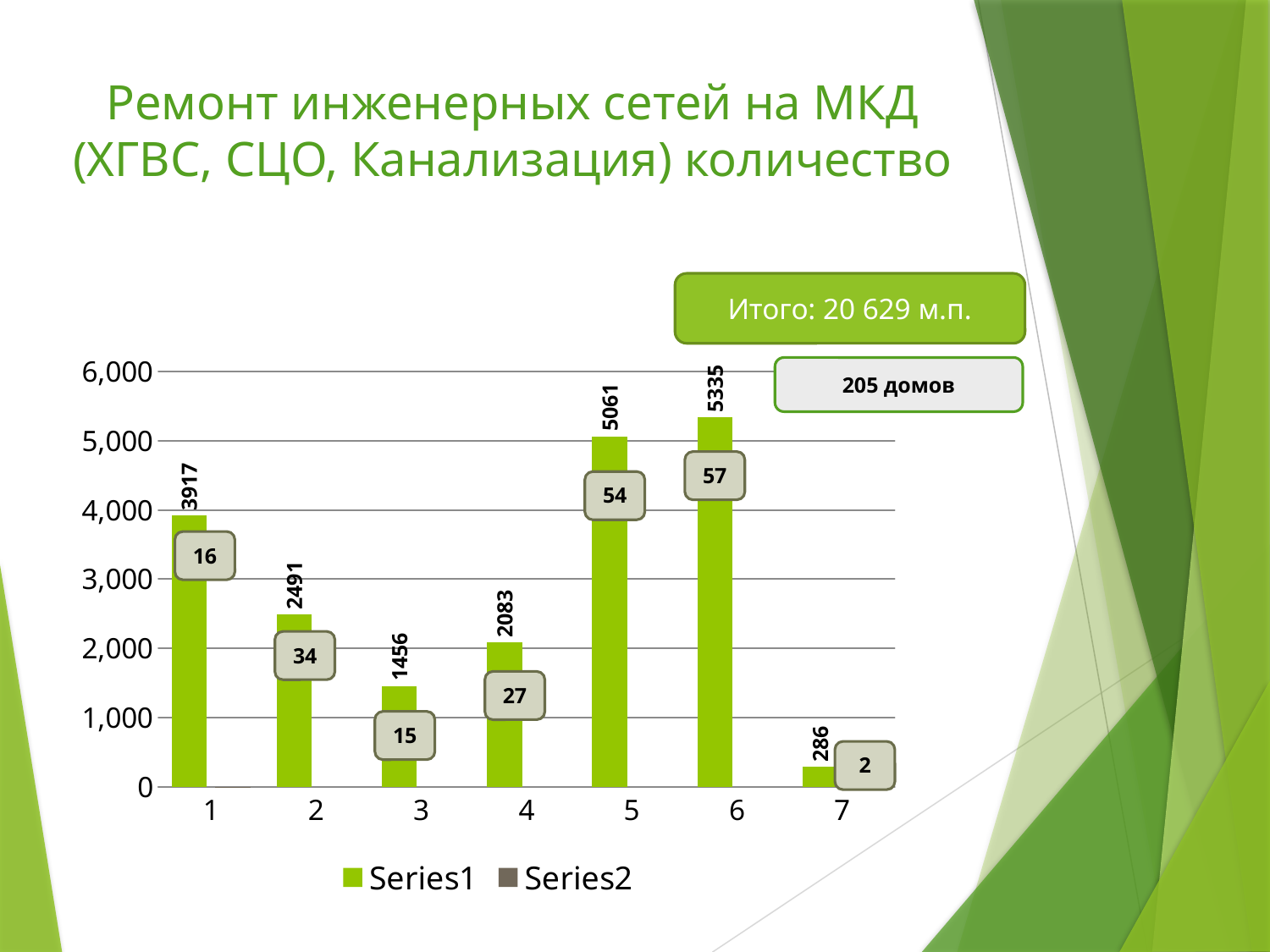
What is the Series1 value for category 3? 1456 What is the Series1 value for category 1? 3917 What is the Series1 value for category 7? 286 Which category has the highest Series1 value? 6 What is the Series1 value for category 6? 5335 Which category has the lowest Series1 value? 7 How many categories are shown on the x axis? 7 How many series does the legend list? 2 Which is larger, the Series1 value for category 2 or for category 4? category 2 What type of chart is shown on the slide? bar chart What is the difference between the Series1 values for categories 2 and 4? 408 What is the difference between the Series1 values for categories 6 and 5? 274